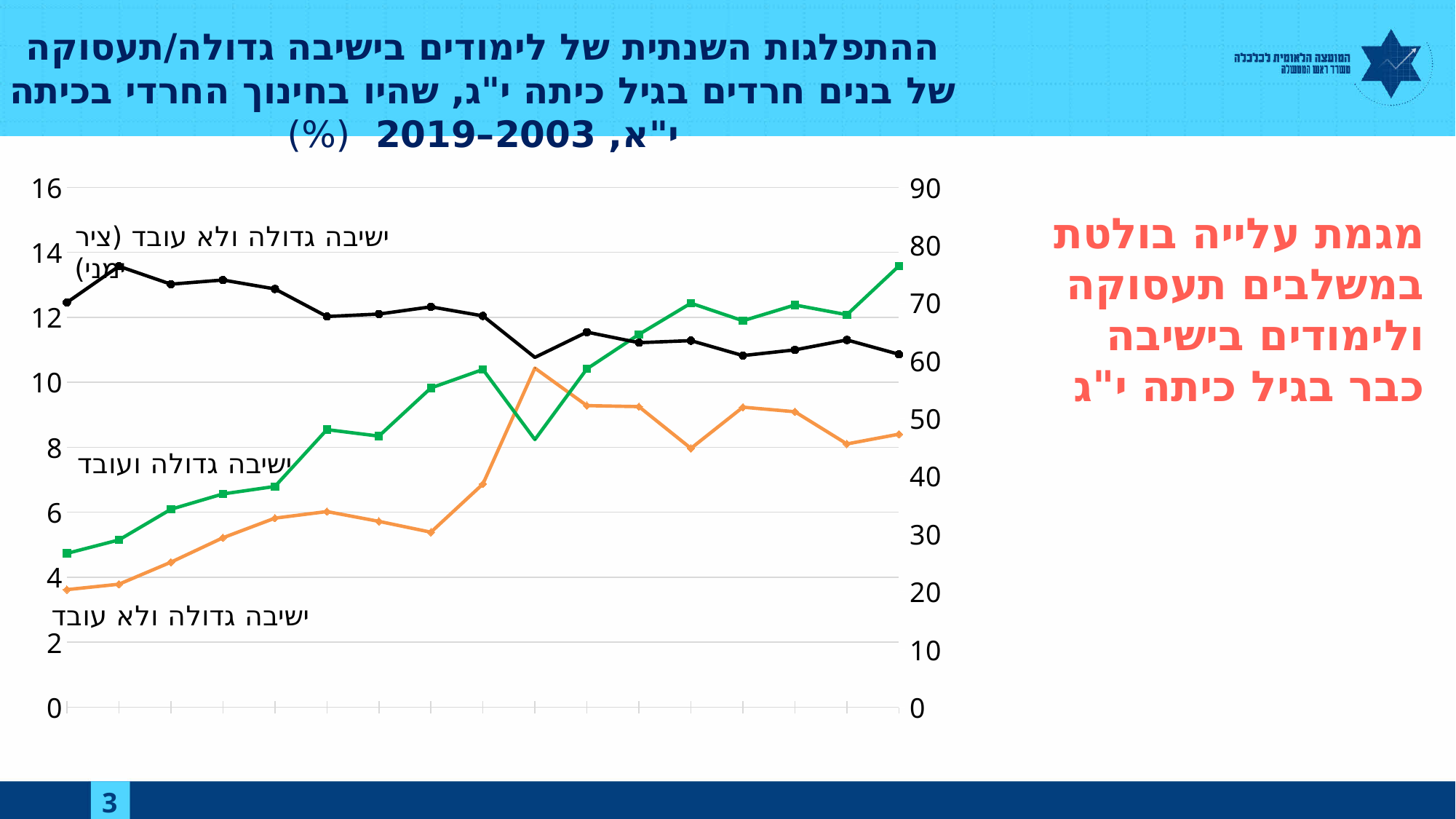
What kind of chart is shown on the slide? line chart Is the value of the orange line at its leftmost point greater or less than 6 on the left axis? less Does the black line (ישיבה גדולה ולא עובד, secondary axis) generally rise or fall from left to right? fall Is the value of the green line (ישיבה גדולה ועובד) at its rightmost point greater or less than 12 on the left axis? greater What is the maximum value shown on the left-hand axis? 16 Does the green line (ישיבה גדולה ועובד) generally rise or fall from left to right? rise How many data points does each line in the chart have? 17 What is the maximum value shown on the right-hand (secondary) axis? 90 How many lines (series) are plotted in the chart? 3 Is the value of the black line (secondary axis) at its leftmost point greater or less than 60 on the right axis? greater At the rightmost point, which is higher on the left axis: the green line or the orange line? the green line